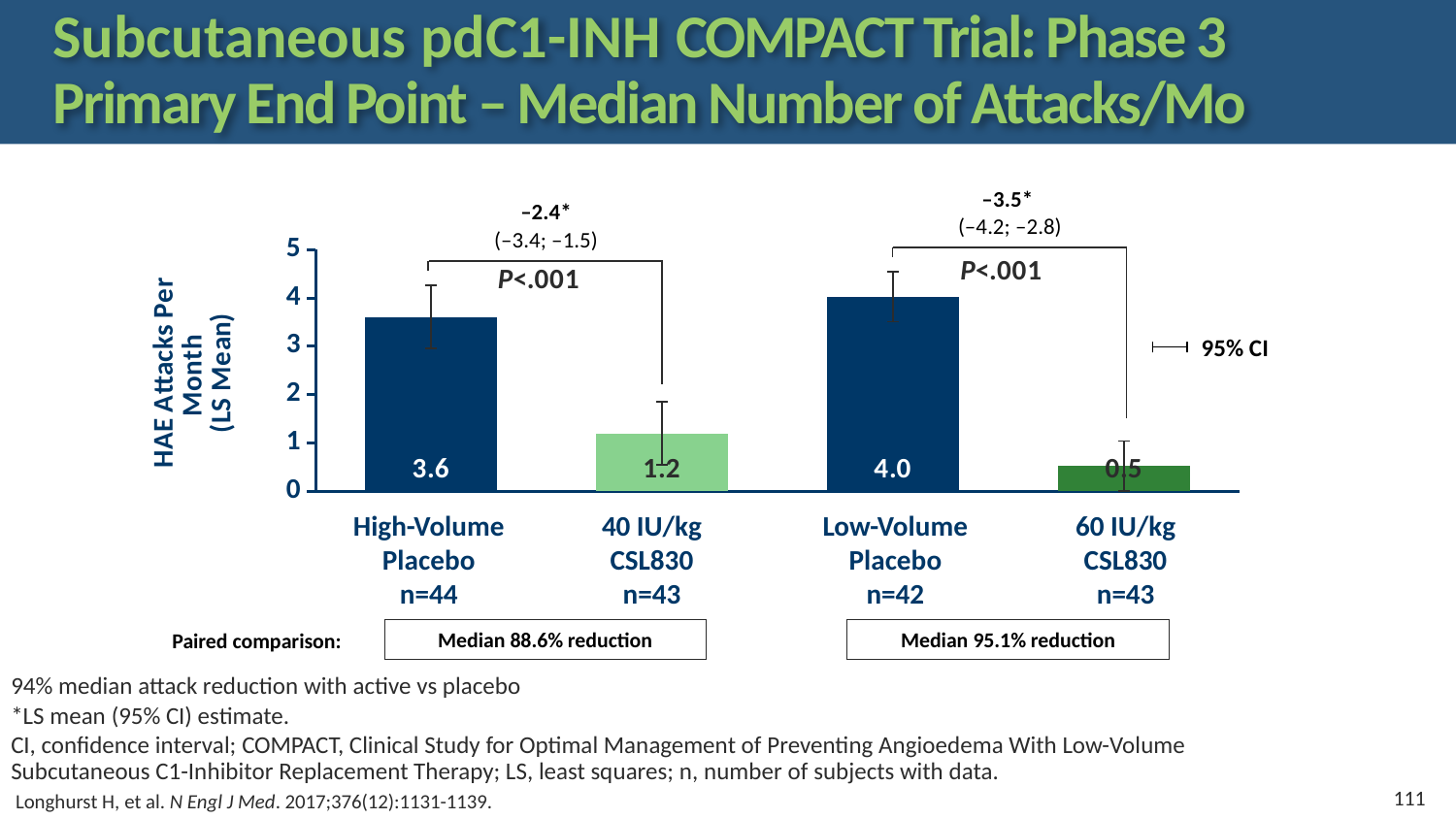
What is the 95% CI shown for the -3.5 treatment difference between Low-Volume Placebo and 60 IU/kg CSL830? (-4.2; -2.8) What type of chart is shown on the slide? Bar chart What is the LS mean number of HAE attacks per month for the 60 IU/kg CSL830 group? 0.5 How many groups are plotted on the chart? 4 What is the difference in LS mean HAE attacks per month between the High-Volume Placebo and 40 IU/kg CSL830 groups? 2.4 Which group has the lowest LS mean number of HAE attacks per month? 60 IU/kg CSL830 Which group has more HAE attacks per month, Low-Volume Placebo or 60 IU/kg CSL830? Low-Volume Placebo What is the label of the y axis of the chart? HAE Attacks Per Month (LS Mean) Which group has the highest LS mean number of HAE attacks per month? Low-Volume Placebo What is the LS mean number of HAE attacks per month for the 40 IU/kg CSL830 group? 1.2 What is the LS mean number of HAE attacks per month for the Low-Volume Placebo group? 4.0 What is the LS mean number of HAE attacks per month for the High-Volume Placebo group? 3.6